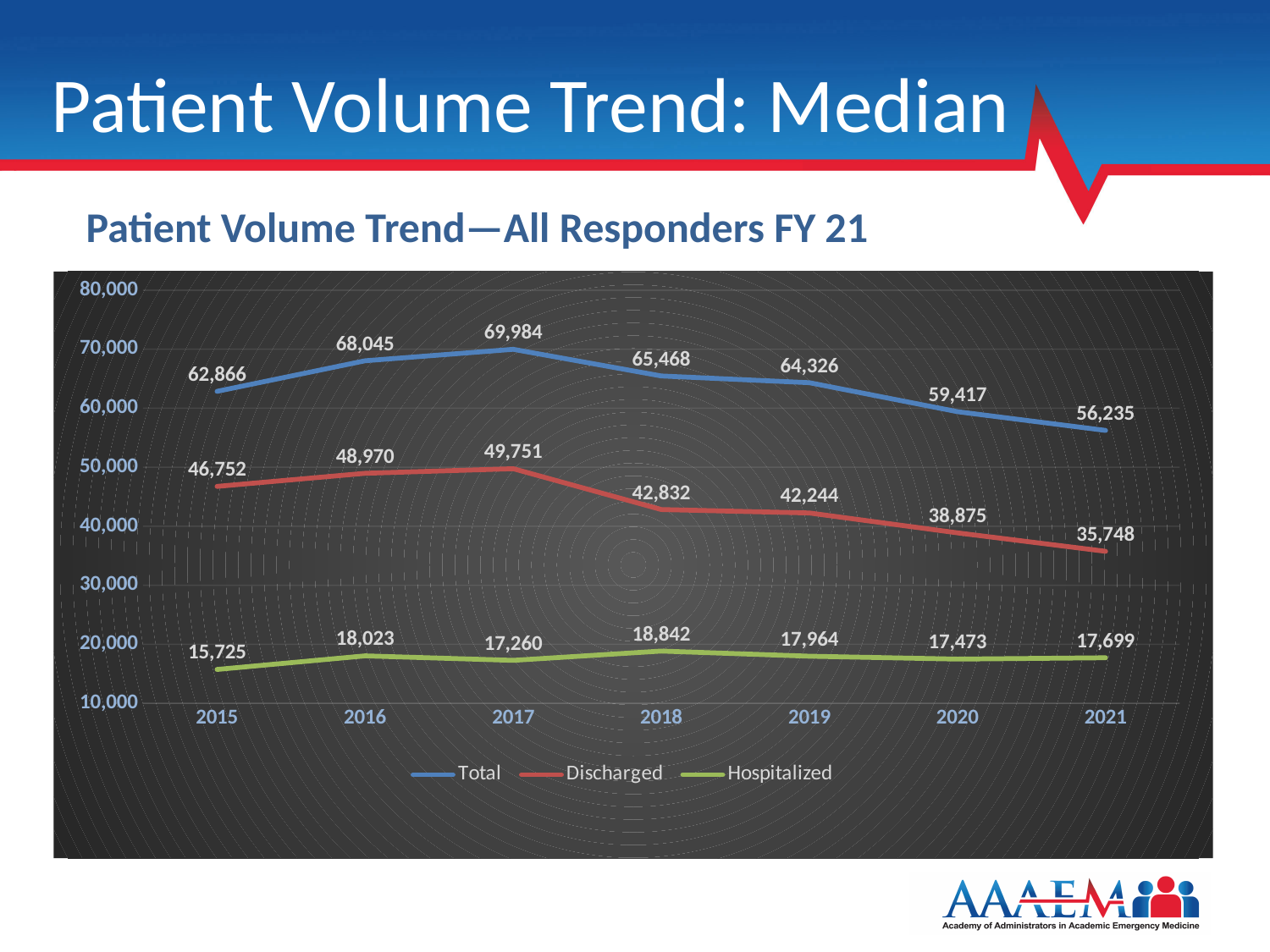
How many years are shown on the x axis? 7 What is the Total value for 2017? 69,984 What kind of chart is shown? line chart What is the Discharged value for 2020? 38,875 In which year is the Discharged series lowest? 2021 Does the Discharged series rise or fall from 2017 to 2021? fall What is the Hospitalized value for 2015? 15,725 What is the difference between the Total values for 2017 and 2021? 13,749 How many series does the legend list? 3 Which is larger, the Hospitalized value for 2018 or for 2016? 2018 Is the Total value for 2021 greater or less than 60,000? less In which year is the Total series highest? 2017